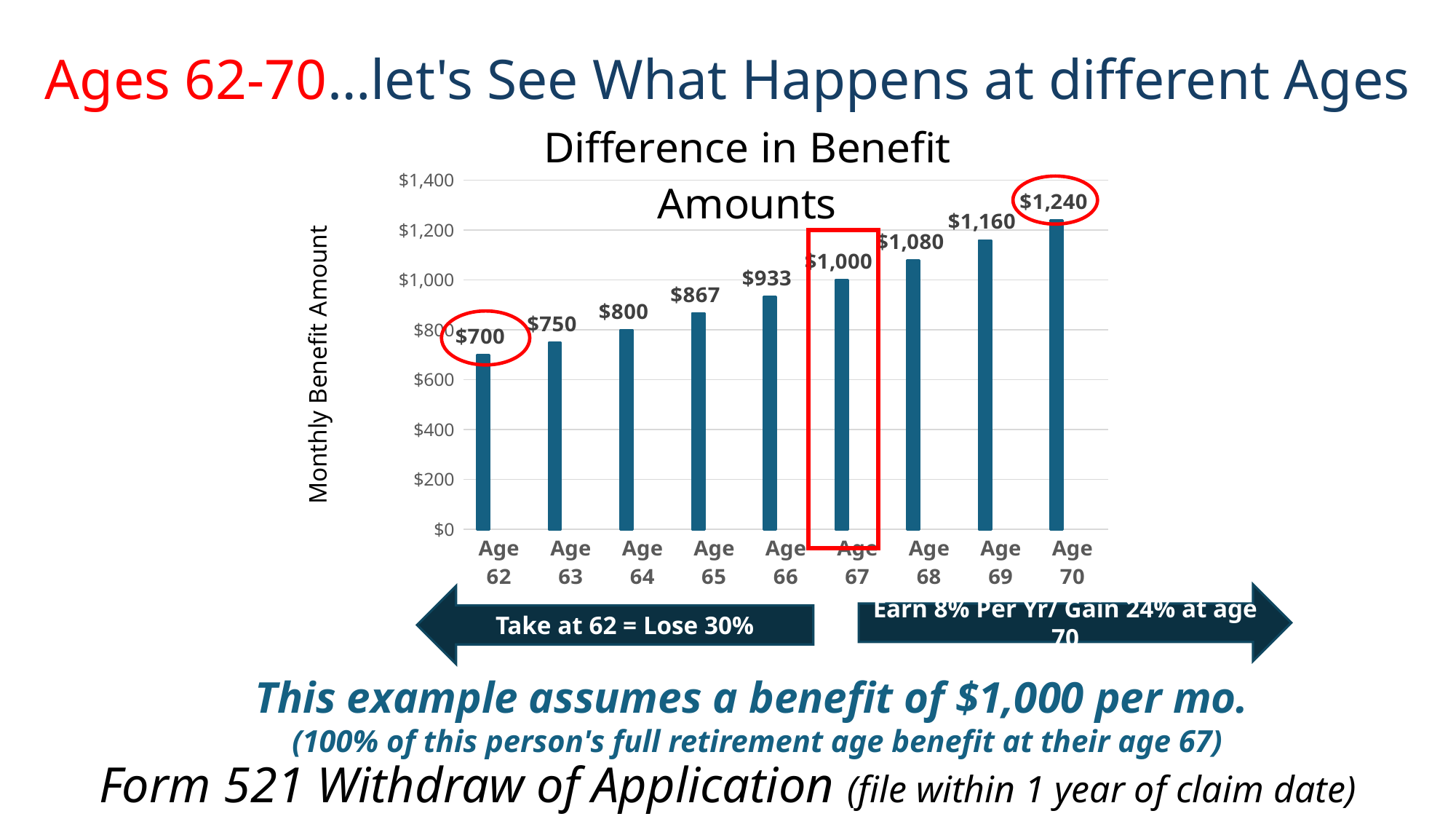
Which age has the lowest monthly benefit amount? Age 62 How many age categories are shown on the x axis? 9 Which is larger, the monthly benefit amount at Age 66 or at Age 69? Age 69 What is the difference between the monthly benefit amount at Age 68 and at Age 67? $80 Do the monthly benefit amounts rise or fall as age increases from 62 to 70? rise What is the monthly benefit amount at Age 62? $700 Is the value for Age 64 greater or less than $1,000? less Which age has the highest monthly benefit amount? Age 70 What is the monthly benefit amount at Age 67? $1,000 What is the difference between the monthly benefit amount at Age 70 and at Age 62? $540 What kind of chart is shown on the slide? bar chart What is the monthly benefit amount at Age 65? $867